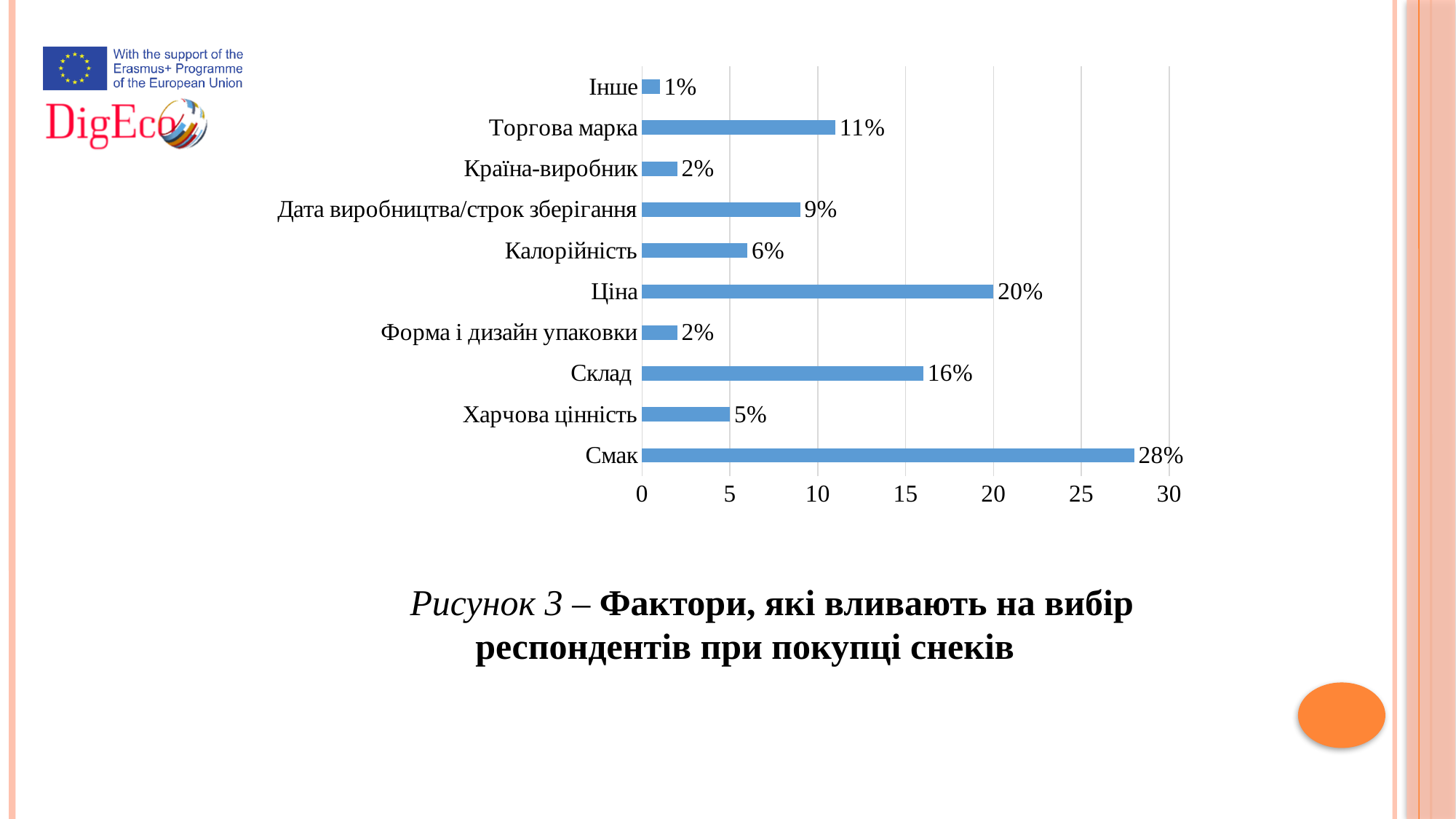
What is the value for Торгова марка? 11% Which is larger, the value for Калорійність or the value for Харчова цінність? Калорійність What is the difference between the values for Смак and Склад? 12% What is the caption of the figure below the chart? Рисунок 3 – Фактори, які вливають на вибір респондентів при покупці снеків How many categories are shown in the chart? 10 What is the difference between the values for Ціна and Торгова марка? 9% Is the value for Дата виробництва/строк зберігання greater or less than 10? less What kind of chart is shown on the slide? bar chart What is the value for Смак? 28% What is the value for Ціна? 20% Which category has the lowest value? Інше Which category has the highest value? Смак